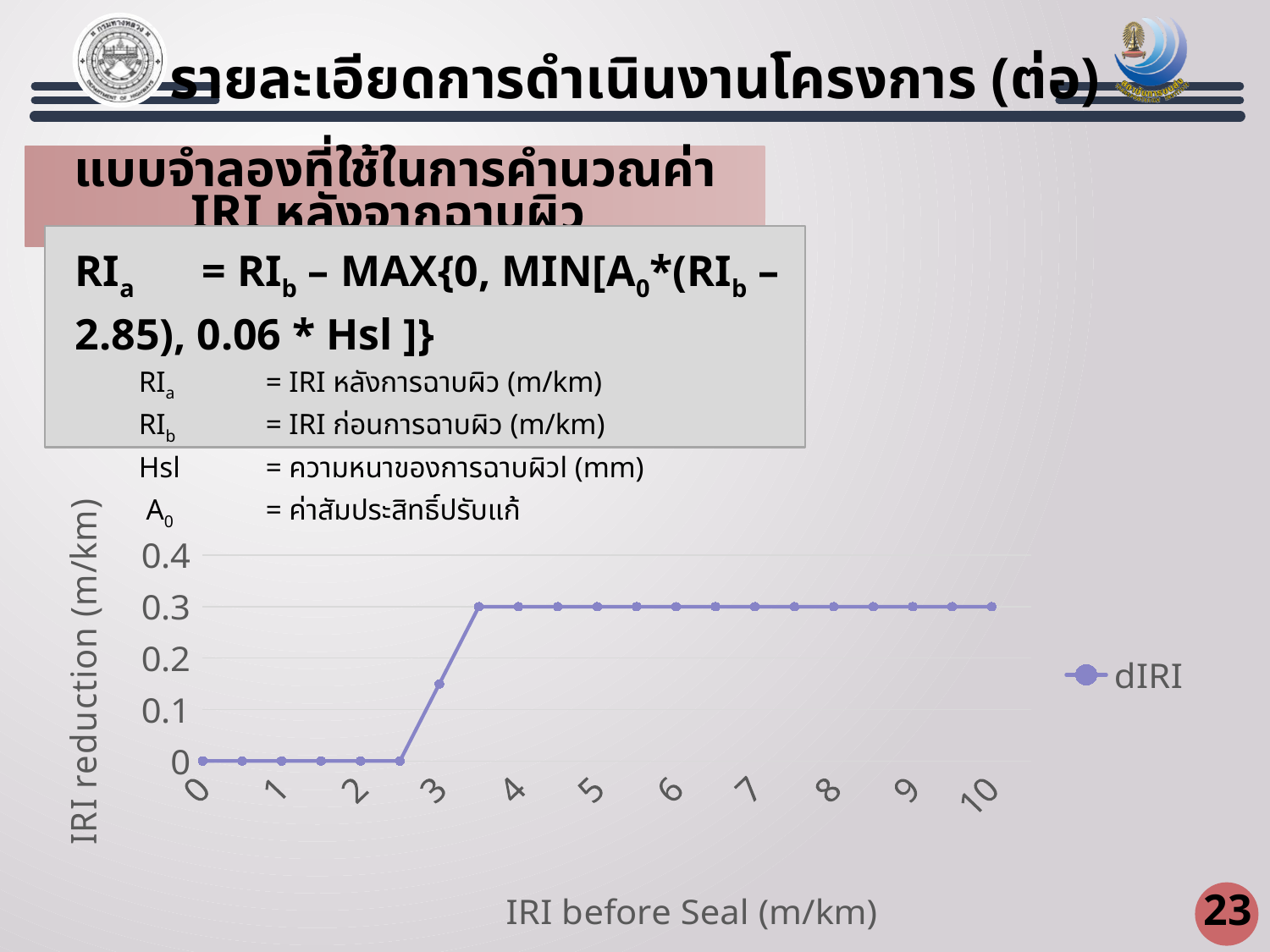
What is the dIRI value when IRI before Seal is 2 m/km? 0 What is the name of the series shown in the chart legend? dIRI Is the dIRI value at IRI before Seal of 3 m/km greater or less than 0.2? less What kind of chart is shown on the slide? line chart How many series does the chart legend list? 1 Which is larger, the dIRI value at IRI before Seal of 1 m/km or at 4 m/km? 4 m/km Is the dIRI value at IRI before Seal of 3 m/km greater or less than 0.1? greater What is the difference between the dIRI value at IRI before Seal of 6 m/km and at 2 m/km? 0.3 What is the label of the x axis of the chart? IRI before Seal (m/km) What is the dIRI value when IRI before Seal is 5 m/km? 0.3 What is the dIRI value when IRI before Seal is 10 m/km? 0.3 What is the dIRI value when IRI before Seal is 0 m/km? 0